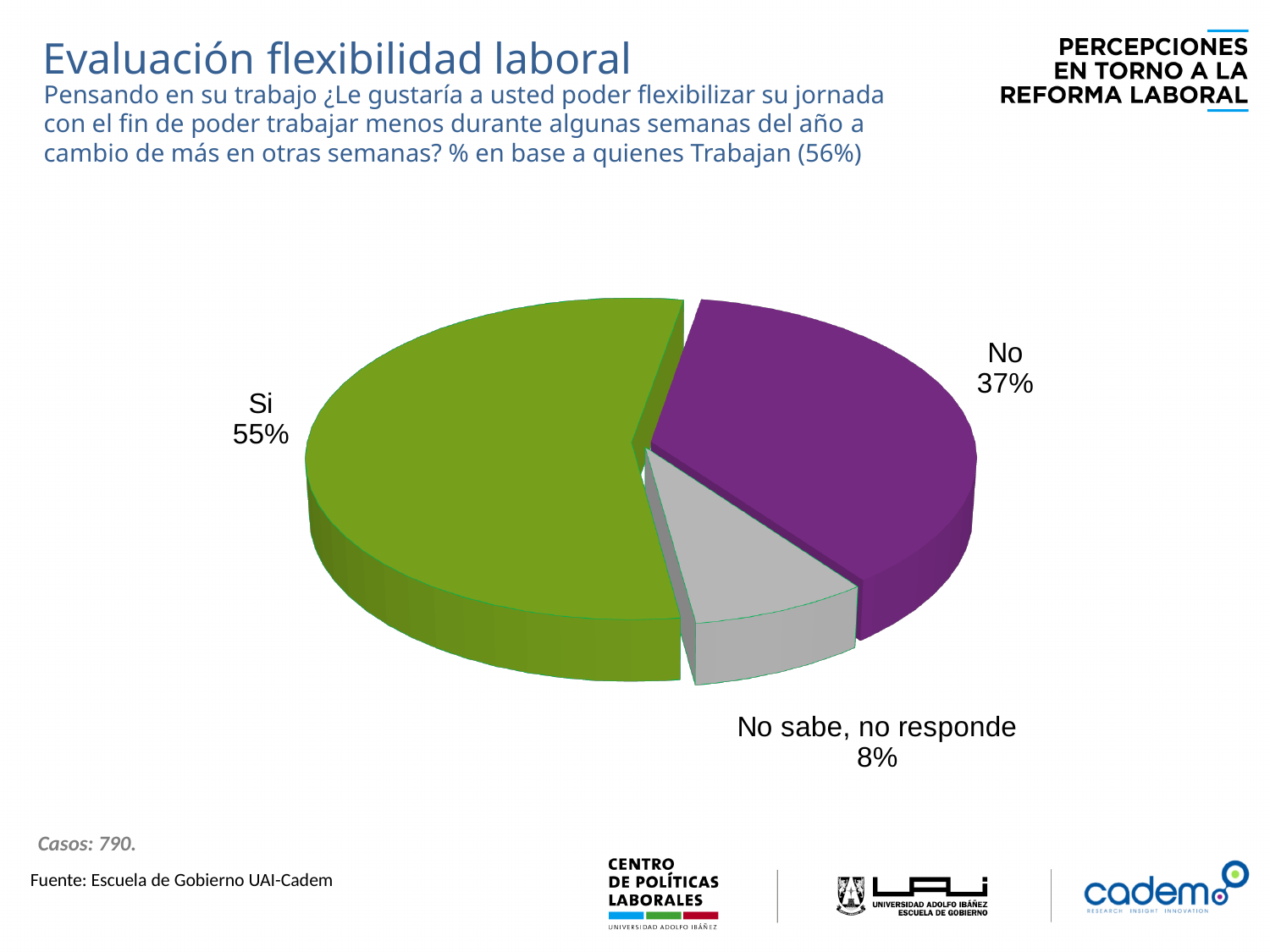
What colour is the "Si" slice? Green What percentage of respondents answered "Si"? 55% How many categories are shown in the pie chart? 3 What kind of chart is shown on the slide? Pie chart What is the difference in percentage points between "Si" and "No"? 18 Which category has the largest share of the pie? Si Which is larger, the share for "No" or the share for "No sabe, no responde"? No What percentage of respondents answered "No"? 37% What colour is the "No" slice? Purple Which category has the smallest share of the pie? No sabe, no responde What is the combined share of "Si" and "No"? 92% What percentage is shown for "No sabe, no responde"? 8%